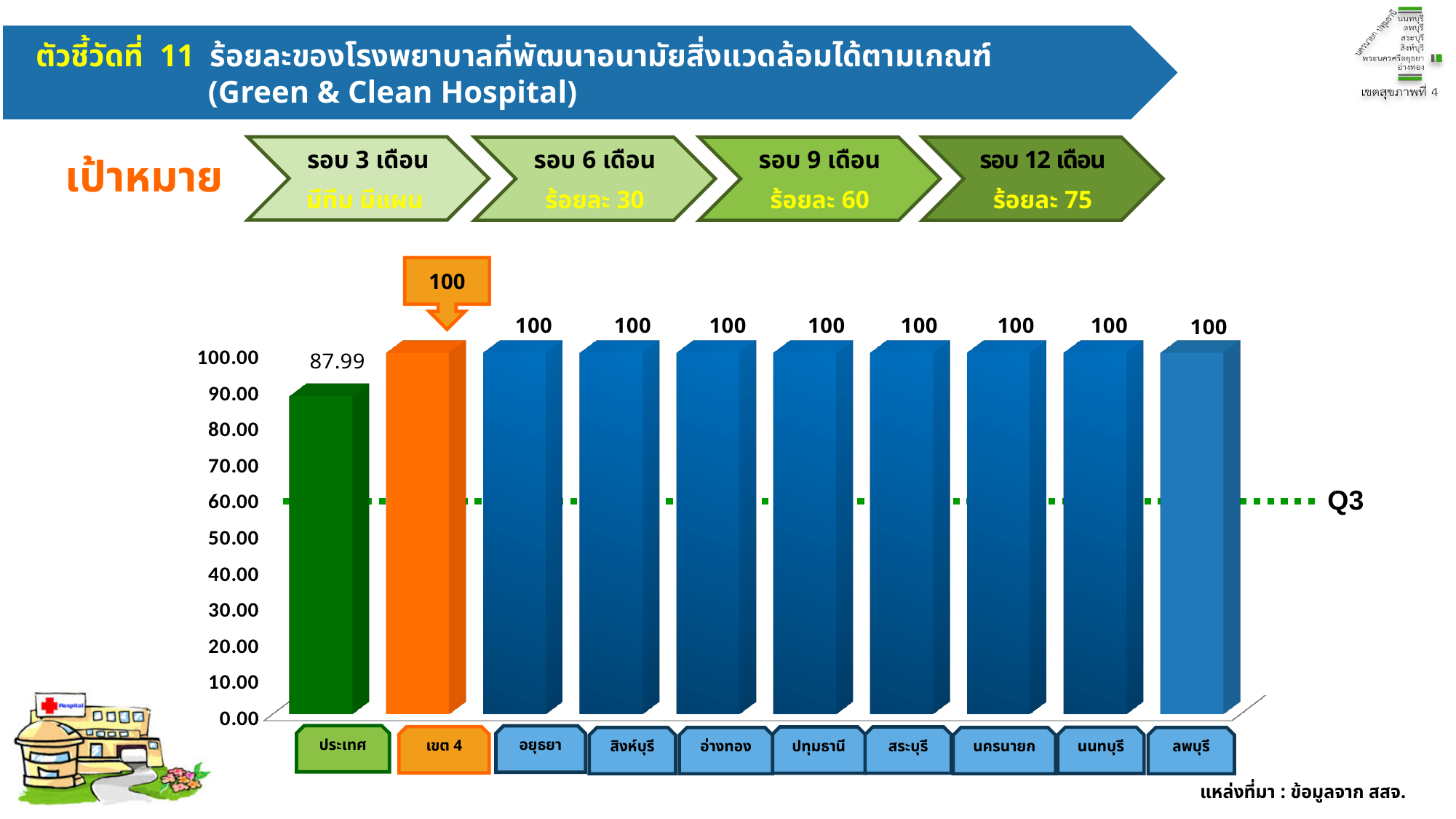
How many categories have a value of 100? 9 What colour is the bar for เขต 4? orange Which category has the lowest value? ประเทศ At what value is the dashed Q3 reference line drawn? 60.00 Which is larger, the value for ประเทศ or the value for อยุธยา? อยุธยา What is the difference between the value for เขต 4 and the value for ประเทศ? 12.01 What kind of chart is shown on the slide? bar chart What is the value for เขต 4? 100 How many categories are shown on the x axis? 10 What is the value for ลพบุรี? 100 What is the value for ประเทศ? 87.99 Is the value for ประเทศ greater or less than 80.00? greater